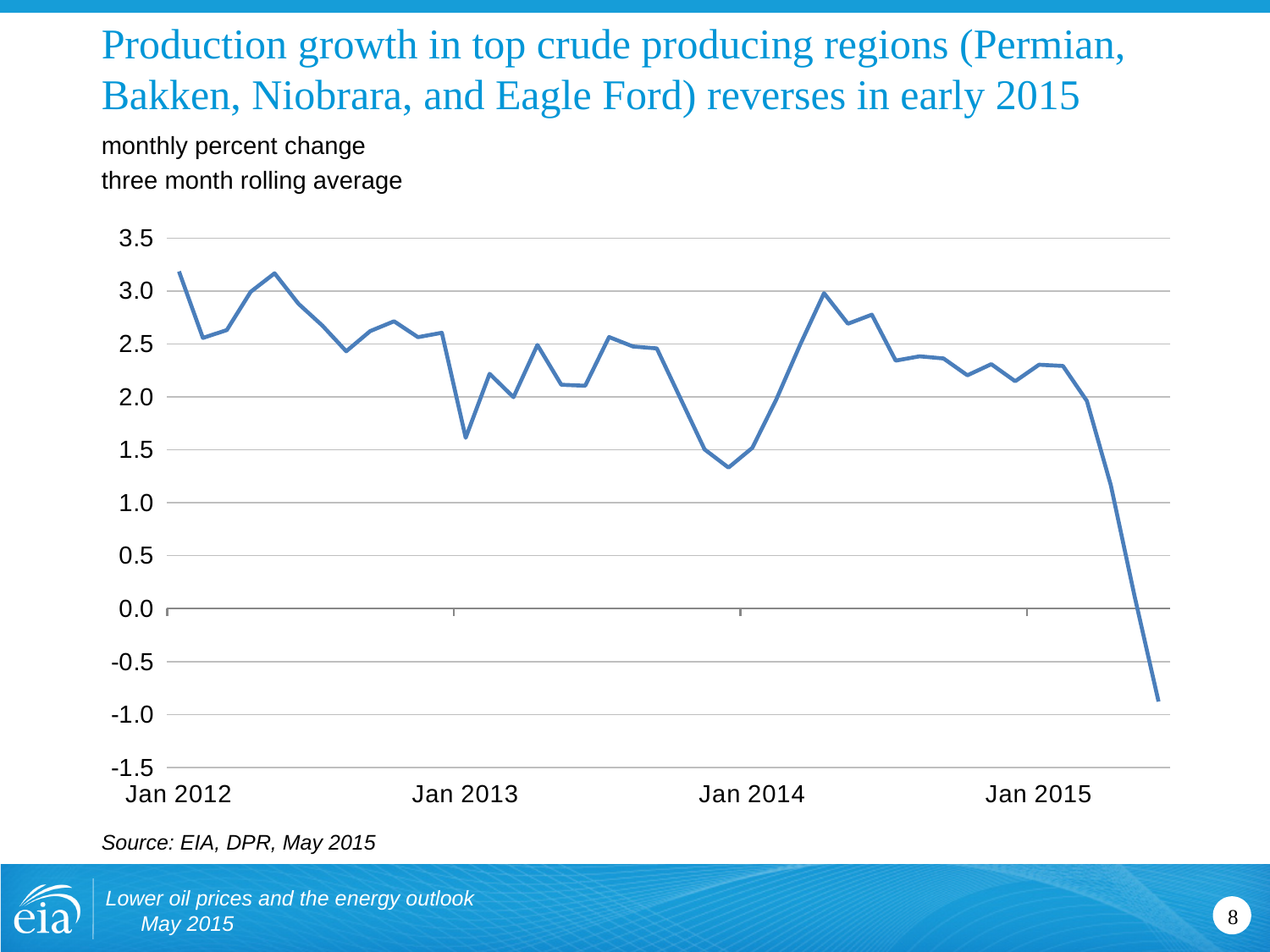
Is the last plotted value at the right end of the line greater or less than 0.0? less Among the four labeled dates on the x axis (Jan 2012, Jan 2013, Jan 2014, Jan 2015), which has the highest value? Jan 2012 Which is larger, the value at Jan 2012 or the value at Jan 2014? Jan 2012 Does the line rise or fall between Jan 2015 and the end of the series? fall What kind of chart is shown on the slide? line chart How many lines (series) are plotted on the chart? 1 Is the value at Jan 2015 greater or less than 2.0? greater Which is larger, the value at Jan 2015 or the final value at the right end of the line? Jan 2015 Is the value at Jan 2012 greater or less than 3.0? greater What is the highest value shown on the y axis? 3.5 What source is cited below the chart? EIA, DPR, May 2015